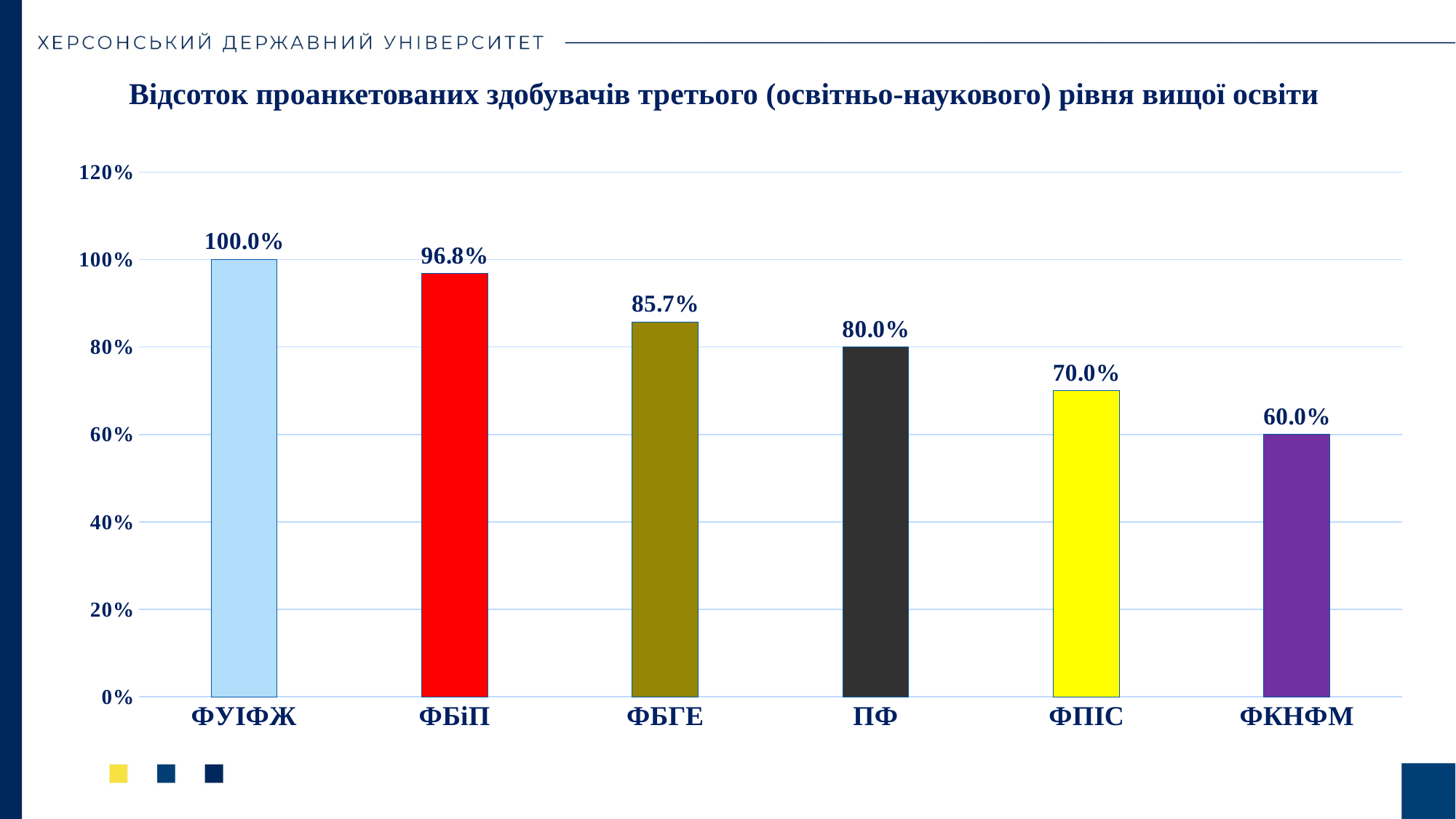
What is the value for ФУІФЖ? 100.0% What kind of chart is shown on the slide? bar chart Do the values rise or fall from left to right along the x axis? fall Which is larger, the value for ФПІС or the value for ФБГЕ? ФБГЕ Is the value for ПФ greater or less than 60%? greater What is the difference between the values for ФБіП and ПФ? 16.8% Which category has the highest value? ФУІФЖ Which category has the lowest value? ФКНФМ How many categories are shown on the x axis? 6 What is the value for ФКНФМ? 60.0% What is the value for ФБГЕ? 85.7% What is the title of the chart? Відсоток проанкетованих здобувачів третього (освітньо-наукового) рівня вищої освіти